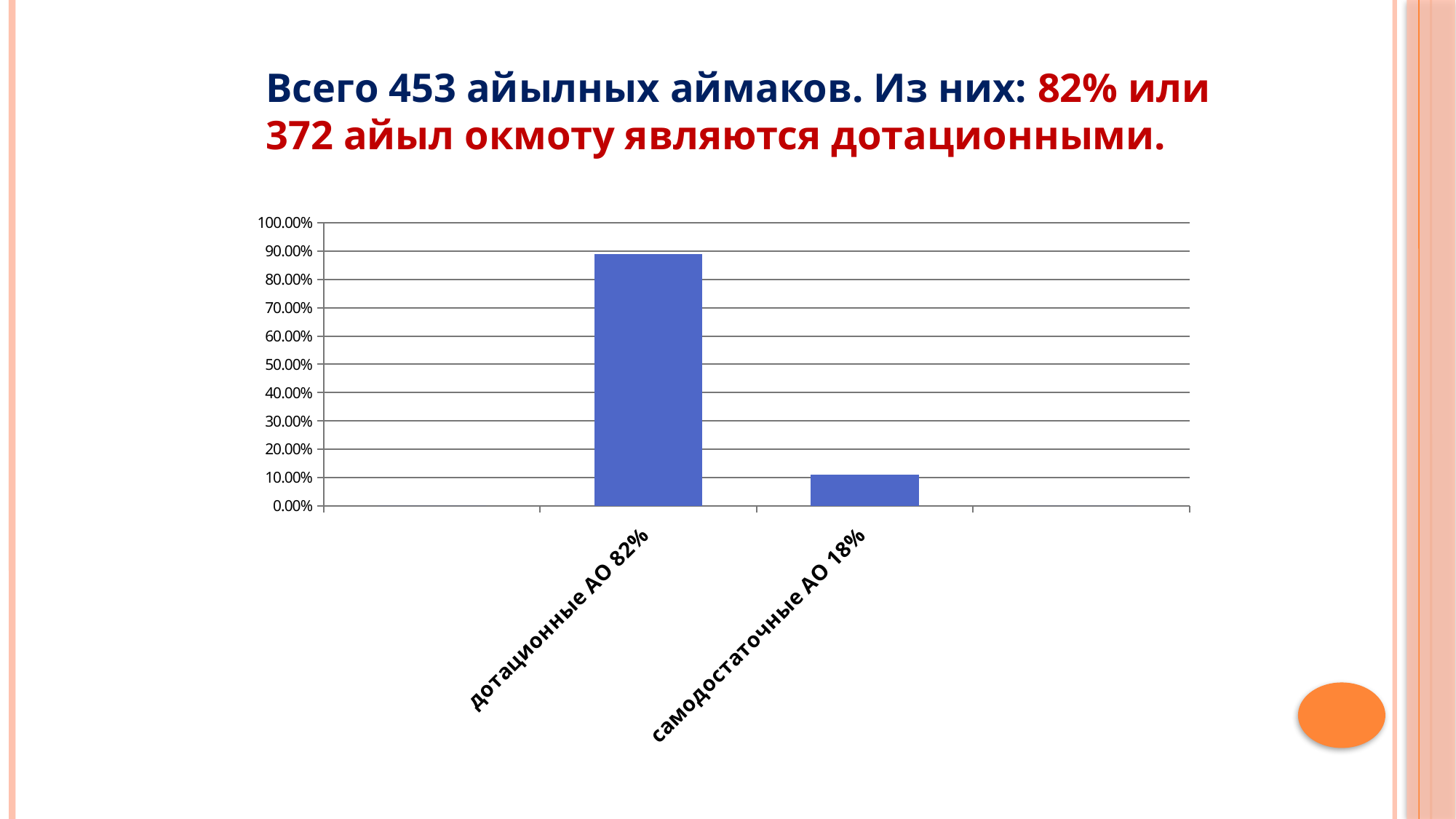
Which category has the highest bar in the chart? дотационные АО 82% Which bar is taller: дотационные АО 82% or самодостаточные АО 18%? дотационные АО 82% Is the value for дотационные АО 82% greater or less than 80.00%? greater How many categories are plotted in the chart? 2 What colour are the bars in the chart? blue What kind of chart is shown on the slide? bar chart Is the value for дотационные АО 82% greater or less than 50.00%? greater What is the highest tick label shown on the vertical axis of the chart? 100.00% Is the value for самодостаточные АО 18% greater or less than 30.00%? less Which category has the lowest bar in the chart? самодостаточные АО 18%